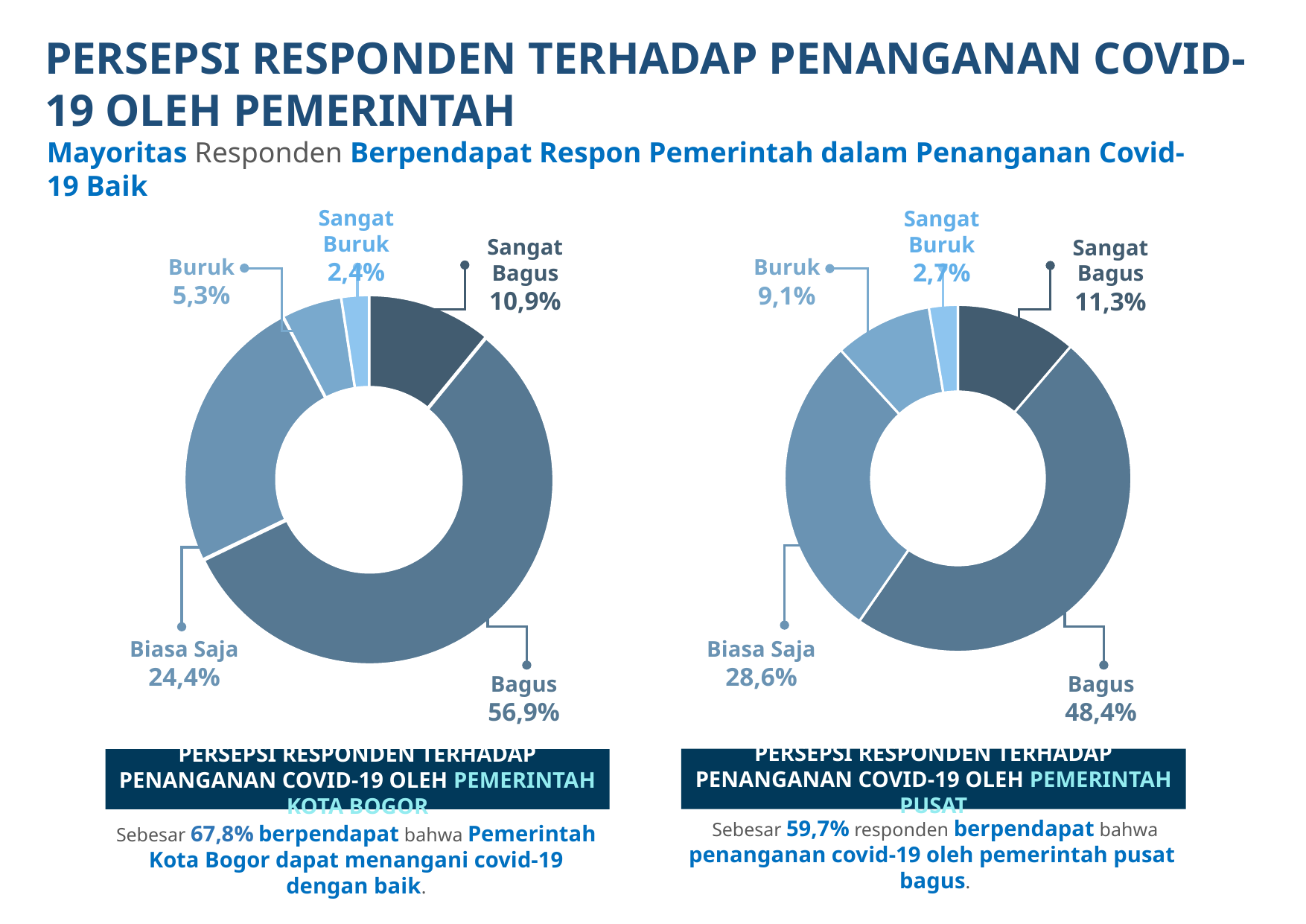
In the right chart (Pemerintah Pusat), what is the difference between the "Biasa Saja" and "Sangat Bagus" shares? 17,3% How many categories are shown in the left chart (Pemerintah Kota Bogor)? 5 In the right chart (Pemerintah Pusat), what is the share for "Buruk"? 9,1% Which chart has the larger "Buruk" share, the left (Pemerintah Kota Bogor) or the right (Pemerintah Pusat)? Right (Pemerintah Pusat) In the left chart (Pemerintah Kota Bogor), which category has the largest share? Bagus In the left chart (Pemerintah Kota Bogor), what is the share for "Sangat Buruk"? 2,4% In the left chart (Pemerintah Kota Bogor), what is the combined share of "Sangat Bagus" and "Bagus"? 67,8% In the right chart (Pemerintah Pusat), what percentage of respondents answered "Biasa Saja"? 28,6% In the left chart (Pemerintah Kota Bogor), what percentage of respondents answered "Bagus"? 56,9% In the right chart (Pemerintah Pusat), which category has the smallest share? Sangat Buruk What is the difference between the "Bagus" share in the left chart (Pemerintah Kota Bogor) and the "Bagus" share in the right chart (Pemerintah Pusat)? 8,5% What type of chart is used on this slide? Donut (pie) chart